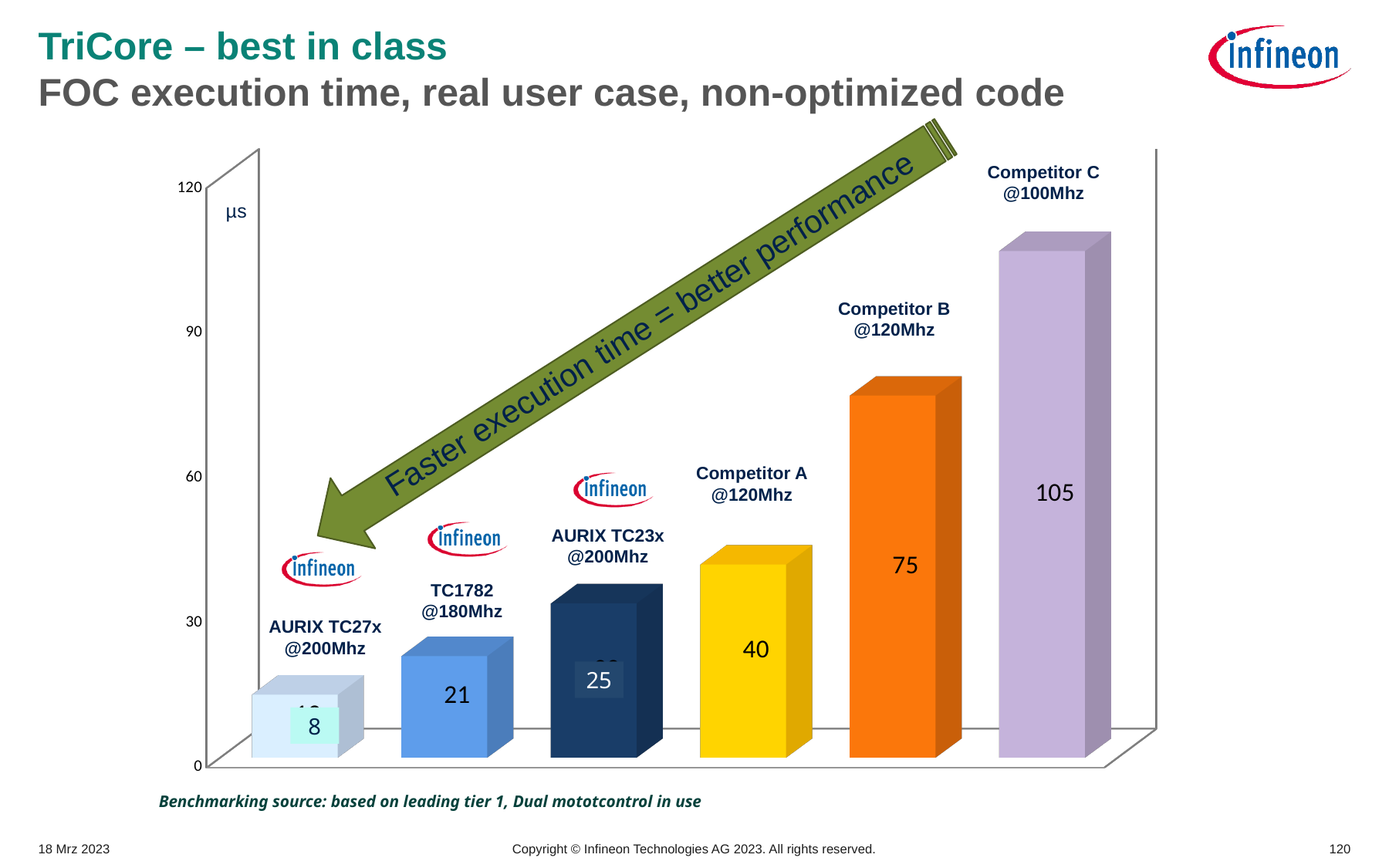
What is the FOC execution time for Competitor B @120Mhz? 75 Which has a larger execution time, Competitor A or TC1782? Competitor A What is the difference in execution time between Competitor C and Competitor B? 30 Which device has the highest FOC execution time? Competitor C @100Mhz Which device has the lowest FOC execution time? AURIX TC27x @200Mhz What is the FOC execution time for TC1782 @180Mhz? 21 Is the execution time for Competitor B greater or less than 60? greater How many devices are compared in the chart? 6 What type of chart is shown on the slide? bar chart What is the difference in execution time between Competitor A and TC1782? 19 What is the FOC execution time for Competitor A @120Mhz? 40 What is the FOC execution time for Competitor C @100Mhz? 105